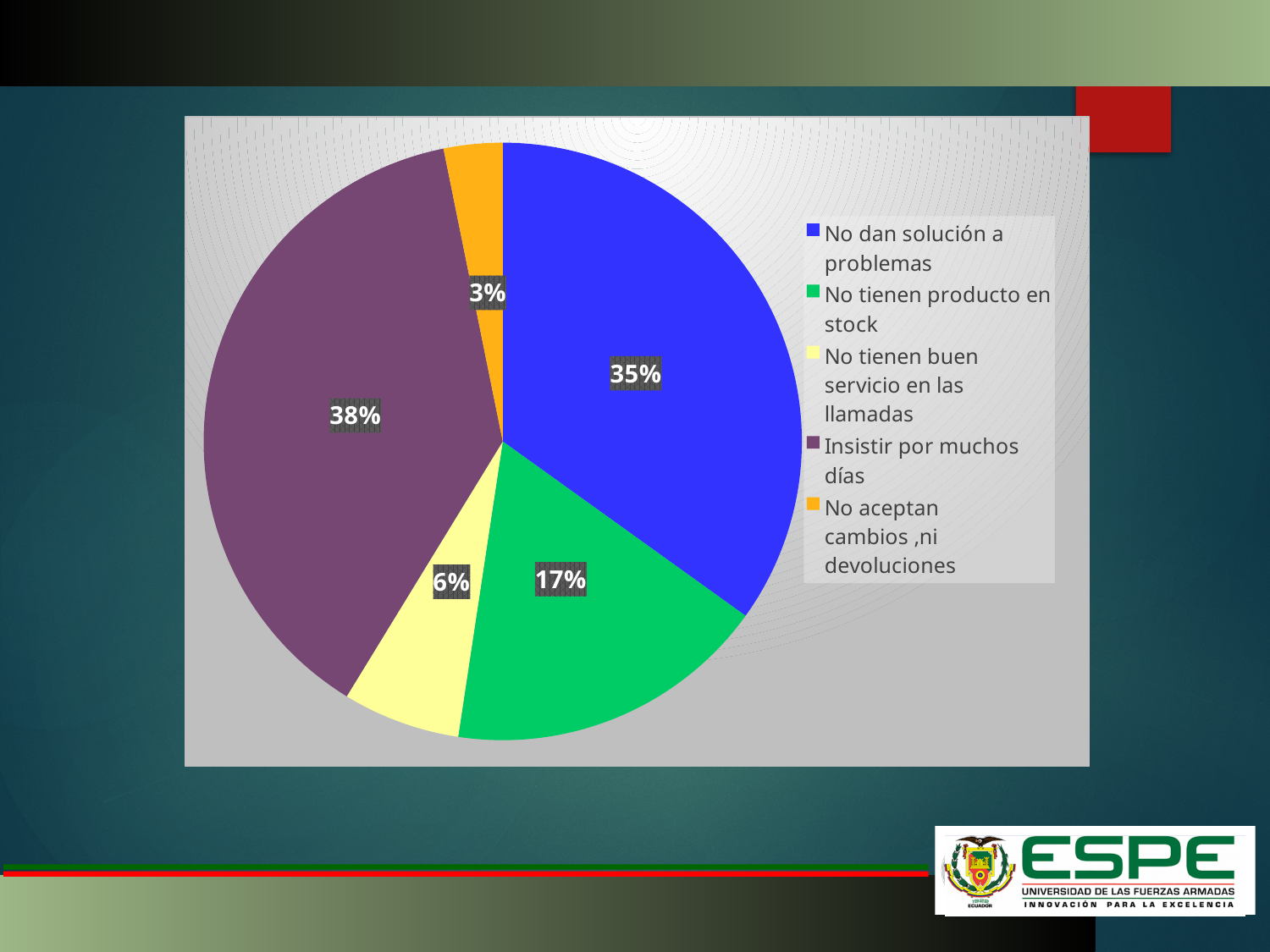
What share of the pie does "No aceptan cambios ,ni devoluciones" represent? 3% What share of the pie does "Insistir por muchos días" represent? 38% Which category has the smallest slice of the pie? No aceptan cambios ,ni devoluciones What share of the pie does "No tienen producto en stock" represent? 17% What kind of chart is shown on the slide? Pie chart What is the difference between the shares of "Insistir por muchos días" and "No dan solución a problemas"? 3% How many categories does the pie chart show? 5 Which category has the largest slice of the pie? Insistir por muchos días Which is larger: the share for "No tienen producto en stock" or the share for "No tienen buen servicio en las llamadas"? No tienen producto en stock What colour is the slice for "No dan solución a problemas"? Blue